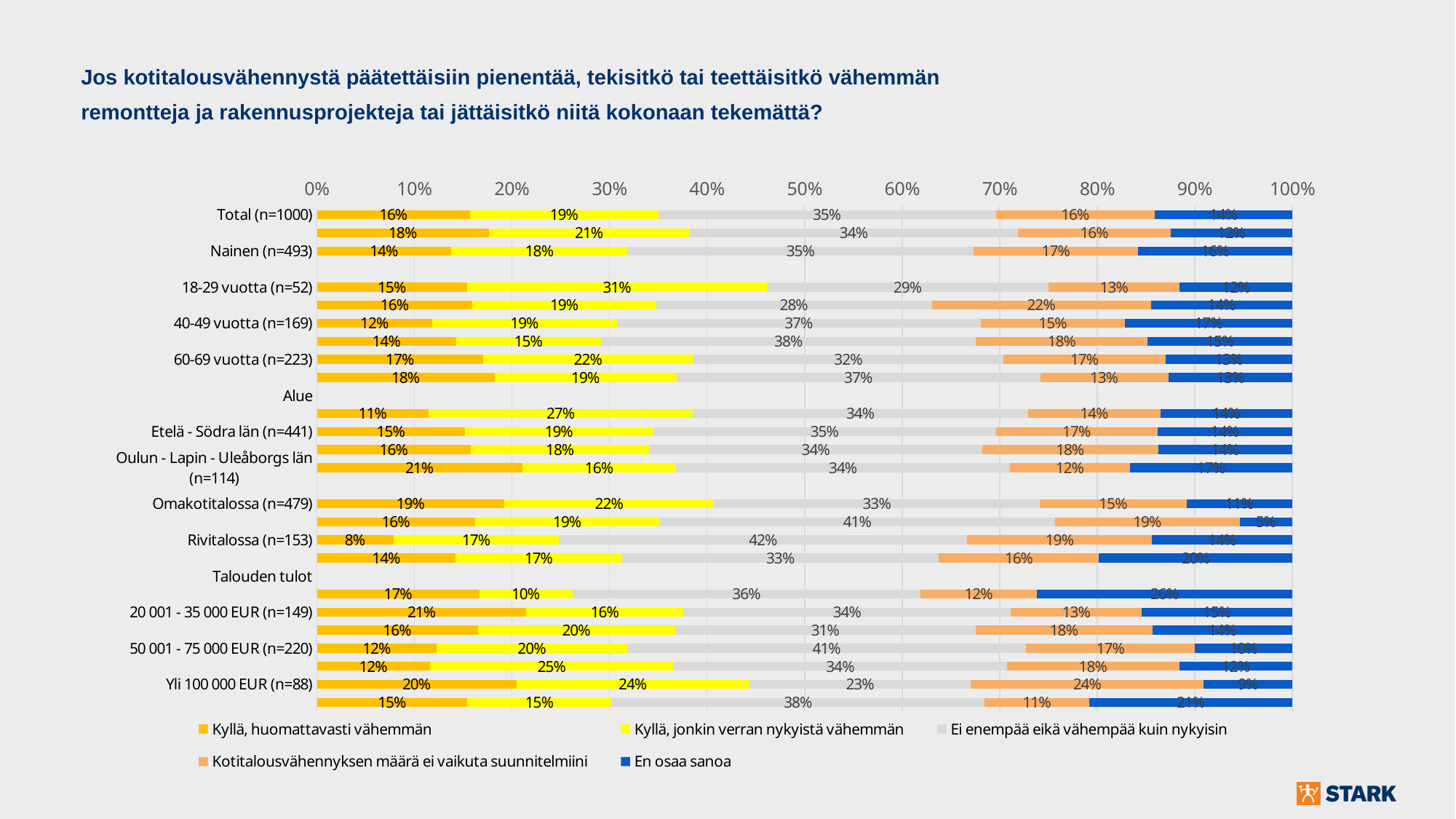
What is the "En osaa sanoa" value for the Yli 100 000 EUR (n=88) row? 9% How many series does the legend list? 5 Which has the larger "Kyllä, huomattavasti vähemmän" value: Etelä - Södra län (n=441) or Oulun - Lapin - Uleåborgs län (n=114)? Oulun - Lapin - Uleåborgs län (n=114) Which has the larger "Ei enempää eikä vähempää kuin nykyisin" value: Rivitalossa (n=153) or Total (n=1000)? Rivitalossa (n=153) What is the value for "Kyllä, huomattavasti vähemmän" in the Rivitalossa (n=153) row? 8% What kind of chart is shown on the slide? Stacked bar chart What colour represents the "En osaa sanoa" series in the legend? Blue What share of the 18-29 vuotta (n=52) group answered "Kyllä, jonkin verran nykyistä vähemmän"? 31% What is the value for "Kotitalousvähennyksen määrä ei vaikuta suunnitelmiini" in the 50 001 - 75 000 EUR (n=220) row? 17% In the Total (n=1000) row, how many percentage points larger is "Ei enempää eikä vähempää kuin nykyisin" than "Kyllä, huomattavasti vähemmän"? 19 percentage points What is the "Kyllä, jonkin verran nykyistä vähemmän" value for Omakotitalossa (n=479)? 22% What percentage of the Total (n=1000) group answered "Ei enempää eikä vähempää kuin nykyisin"? 35%